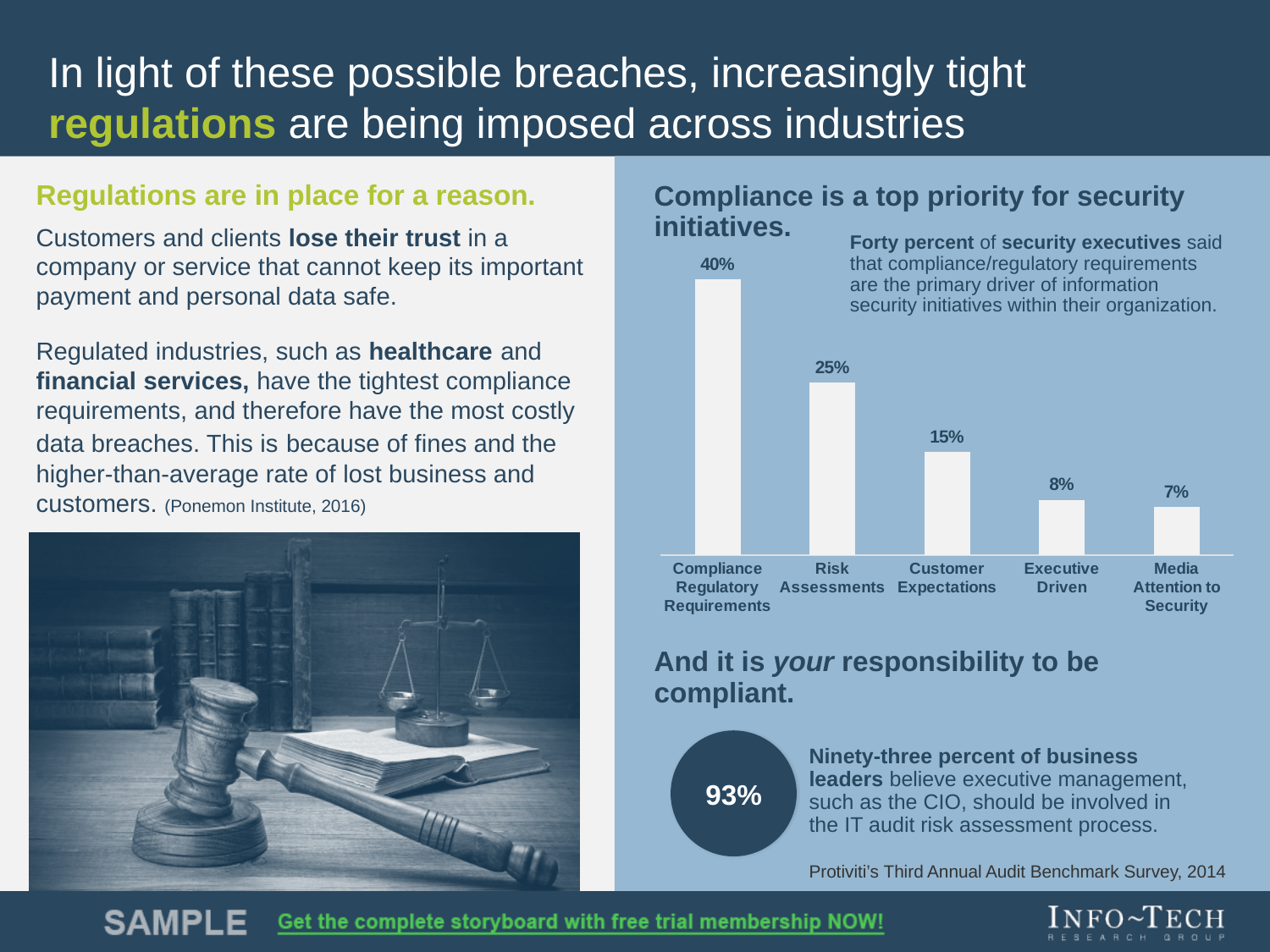
How many categories are shown in the bar chart? 5 What is the value for Customer Expectations? 15% Which category has the lowest value? Media Attention to Security What is the value for Media Attention to Security? 7% Which is larger, the value for Customer Expectations or the value for Executive Driven? Customer Expectations Which category has the highest value? Compliance Regulatory Requirements What is the difference between the values for Executive Driven and Media Attention to Security? 1% What is the difference between the values for Compliance Regulatory Requirements and Risk Assessments? 15% Do the values rise or fall from left to right across the categories? Fall What kind of chart is shown on the slide? Bar chart What is the value for Risk Assessments? 25% What is the value for Compliance Regulatory Requirements? 40%